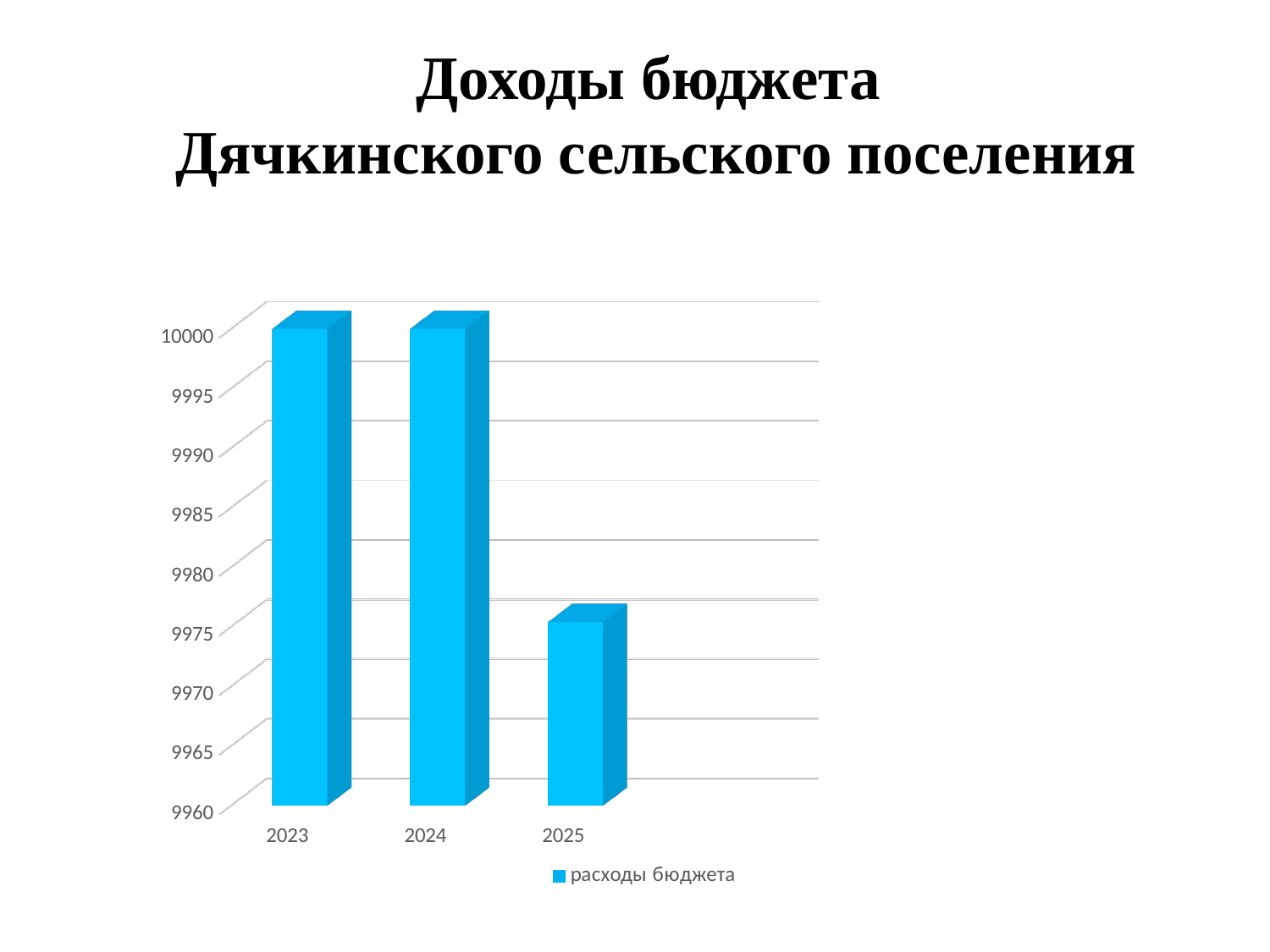
What is the title of the slide? Доходы бюджета Дячкинского сельского поселения What kind of chart is shown on the slide? bar chart Do the values rise or fall from 2023 to 2025? fall How many series does the chart legend list? 1 Is the value for 2023 greater or less than 9990? greater Which year has the lowest value in the chart? 2025 What series name is shown in the chart legend? расходы бюджета Which is larger, the value for 2024 or the value for 2025? 2024 Is the value for 2024 greater or less than 9985? greater Is the value for 2025 greater or less than 9980? less How many years are shown on the x axis of the chart? 3